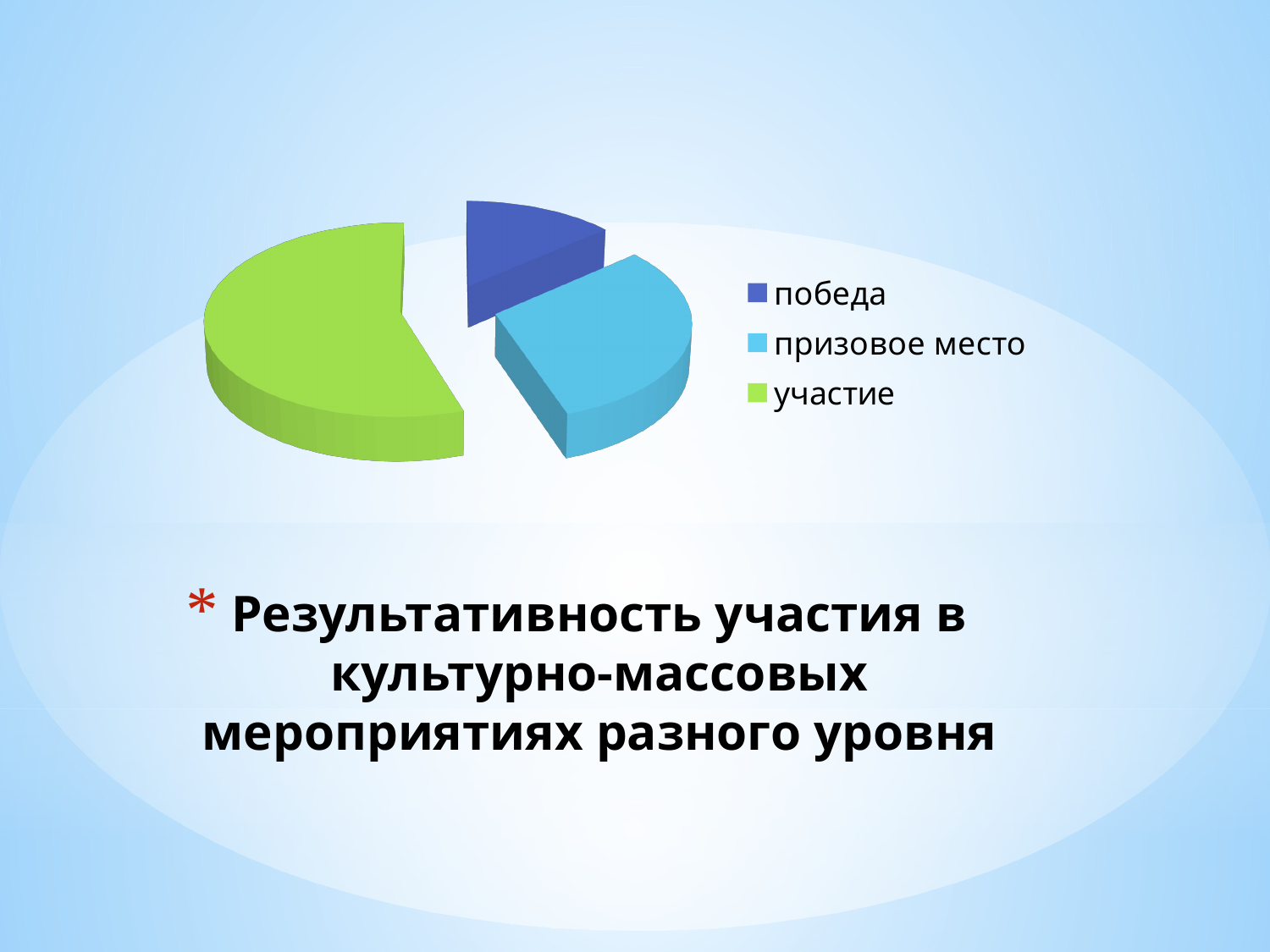
What colour is the slice for участие in the pie chart? green Which legend entry is shown in dark blue in the pie chart? победа How many slices does the pie chart have? 3 Which category has the largest slice in the pie chart? участие Which category has the smallest slice in the pie chart? победа How many entries does the legend of the pie chart list? 3 What kind of chart is shown on the slide? pie chart Which slice is larger in the pie chart, участие or призовое место? участие Which slice is larger in the pie chart, победа or призовое место? призовое место